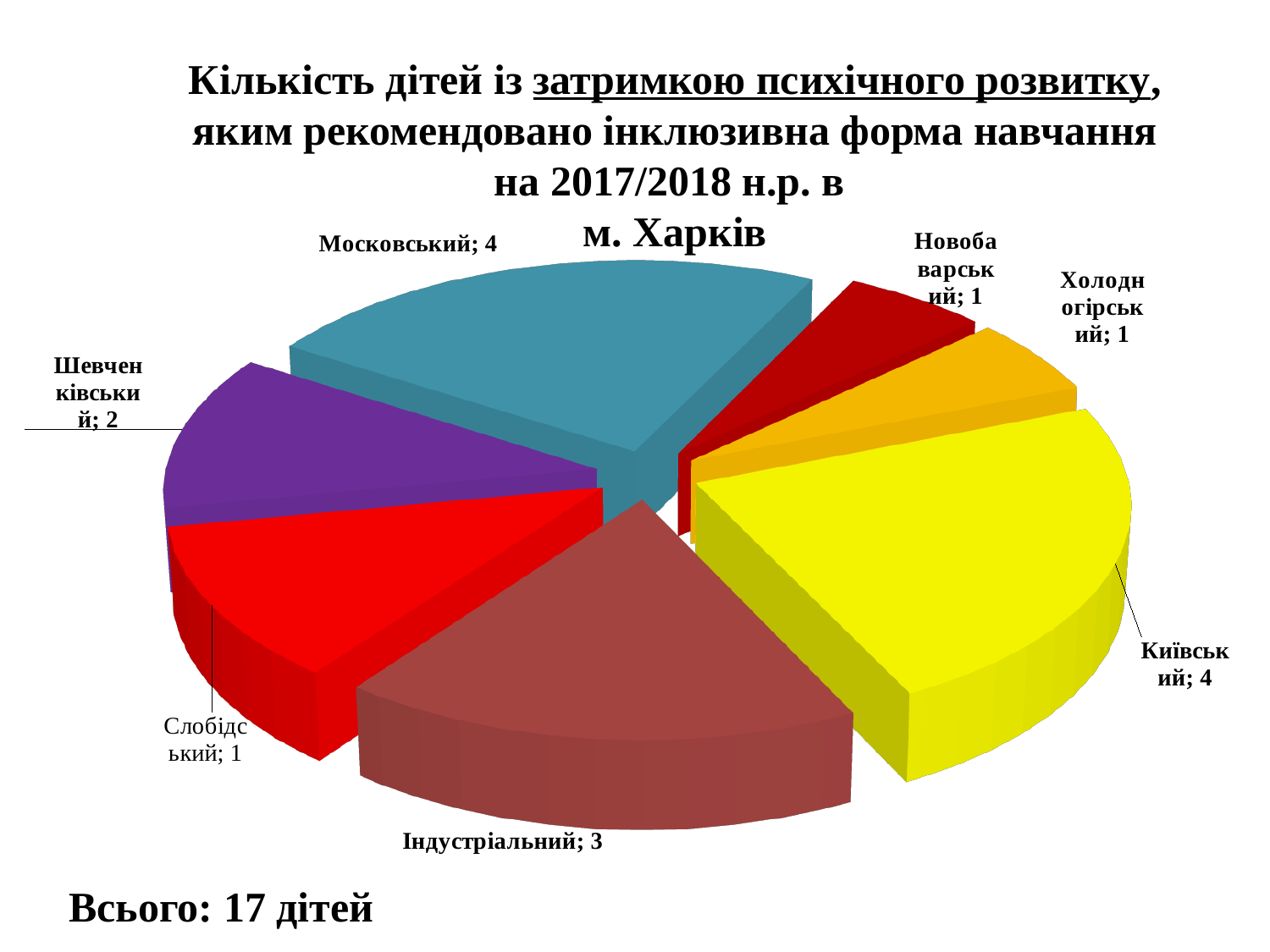
What type of chart is shown on the slide? pie chart What is the value for Індустріальний? 3 Which has a larger value, Індустріальний or Новобаварський? Індустріальний What is the value for Слобідський? 1 What is the difference between the values for Московський and Шевченківський? 2 What is the largest value shown for any district in the pie chart? 4 What is the value for Київський? 4 What total number of children is stated at the bottom of the slide? 17 дітей How many children are shown for Московський district? 4 What is the value for Шевченківський? 2 How many districts (slices) are labelled in the pie chart? 7 What is the difference between the values for Київський and Індустріальний? 1